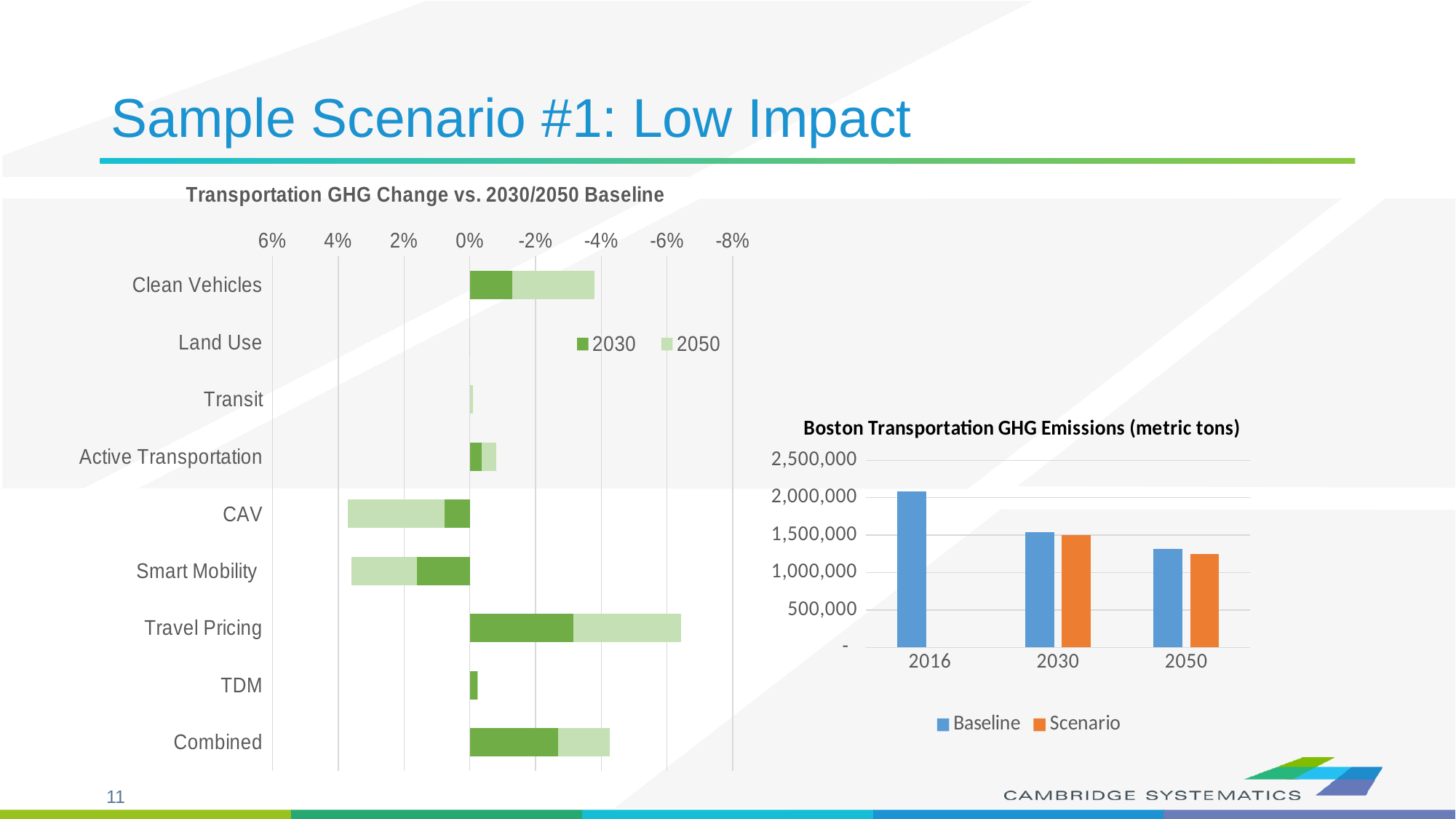
How many series does the legend of the 'Transportation GHG Change vs. 2030/2050 Baseline' chart list? 2 What type of chart is the 'Transportation GHG Change vs. 2030/2050 Baseline' chart? bar chart How many categories are listed on the 'Transportation GHG Change vs. 2030/2050 Baseline' chart? 9 How many series does the legend of the 'Boston Transportation GHG Emissions (metric tons)' chart list? 2 How many years are shown on the x axis of the 'Boston Transportation GHG Emissions (metric tons)' chart? 3 What are the two legend entries on the 'Transportation GHG Change vs. 2030/2050 Baseline' chart? 2030 and 2050 In the 'Boston Transportation GHG Emissions (metric tons)' chart, do the Baseline values rise or fall from 2016 to 2050? fall In the 'Boston Transportation GHG Emissions (metric tons)' chart, is the Baseline value for 2016 greater or less than 2,000,000? greater In the 'Transportation GHG Change vs. 2030/2050 Baseline' chart, which two categories show a positive (increase) GHG change? CAV and Smart Mobility In the 'Boston Transportation GHG Emissions (metric tons)' chart, is the Scenario value for 2050 greater or less than 1,500,000? less In the 'Transportation GHG Change vs. 2030/2050 Baseline' chart, which category shows the largest GHG reduction (longest bar toward the negative side)? Travel Pricing In the 'Boston Transportation GHG Emissions (metric tons)' chart, which year has the highest Baseline value? 2016